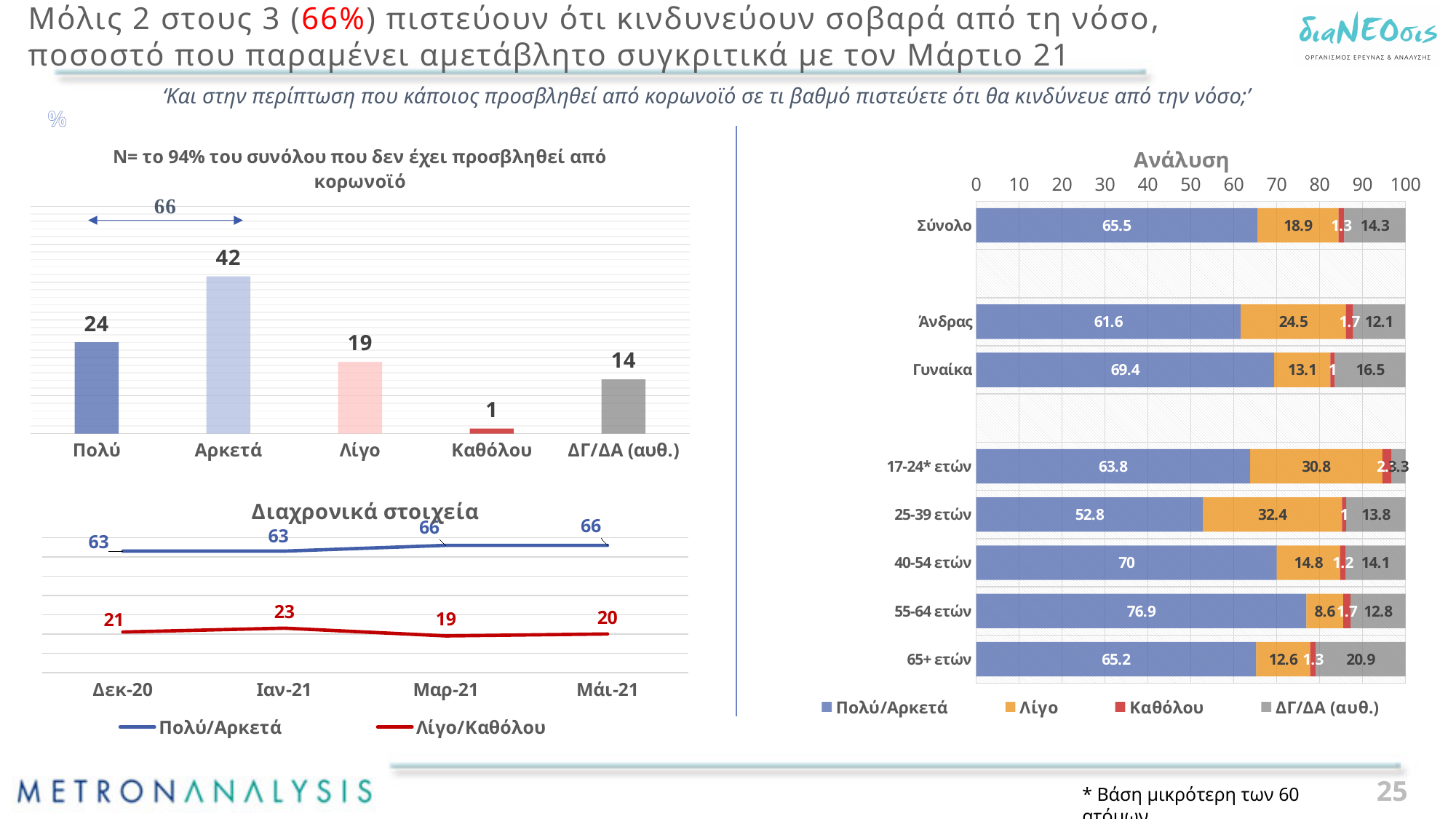
What kind of chart is the Ανάλυση chart on the right? stacked bar chart In the top-left bar chart, which category has the lowest value? Καθόλου How many series does the legend of the Διαχρονικά στοιχεία line chart list? 2 In the Ανάλυση chart on the right, which is larger: the Πολύ/Αρκετά value for Άνδρας or for Γυναίκα? Γυναίκα How many categories are shown in the top-left bar chart? 5 In the top-left bar chart (N= το 94% του συνόλου...), what is the value for Αρκετά? 42 In the top-left bar chart, which category has the highest value? Αρκετά In the line chart titled Διαχρονικά στοιχεία, what is the value of Λίγο/Καθόλου for Ιαν-21? 23 In the Ανάλυση chart on the right, what is the Πολύ/Αρκετά value for 55-64 ετών? 76.9 In the Διαχρονικά στοιχεία line chart, does the Πολύ/Αρκετά series rise or fall from Δεκ-20 to Μάι-21? rise In the Ανάλυση chart on the right, what is the Λίγο value for 25-39 ετών? 32.4 In the top-left bar chart, what is the difference between the values for Πολύ and Λίγο? 5